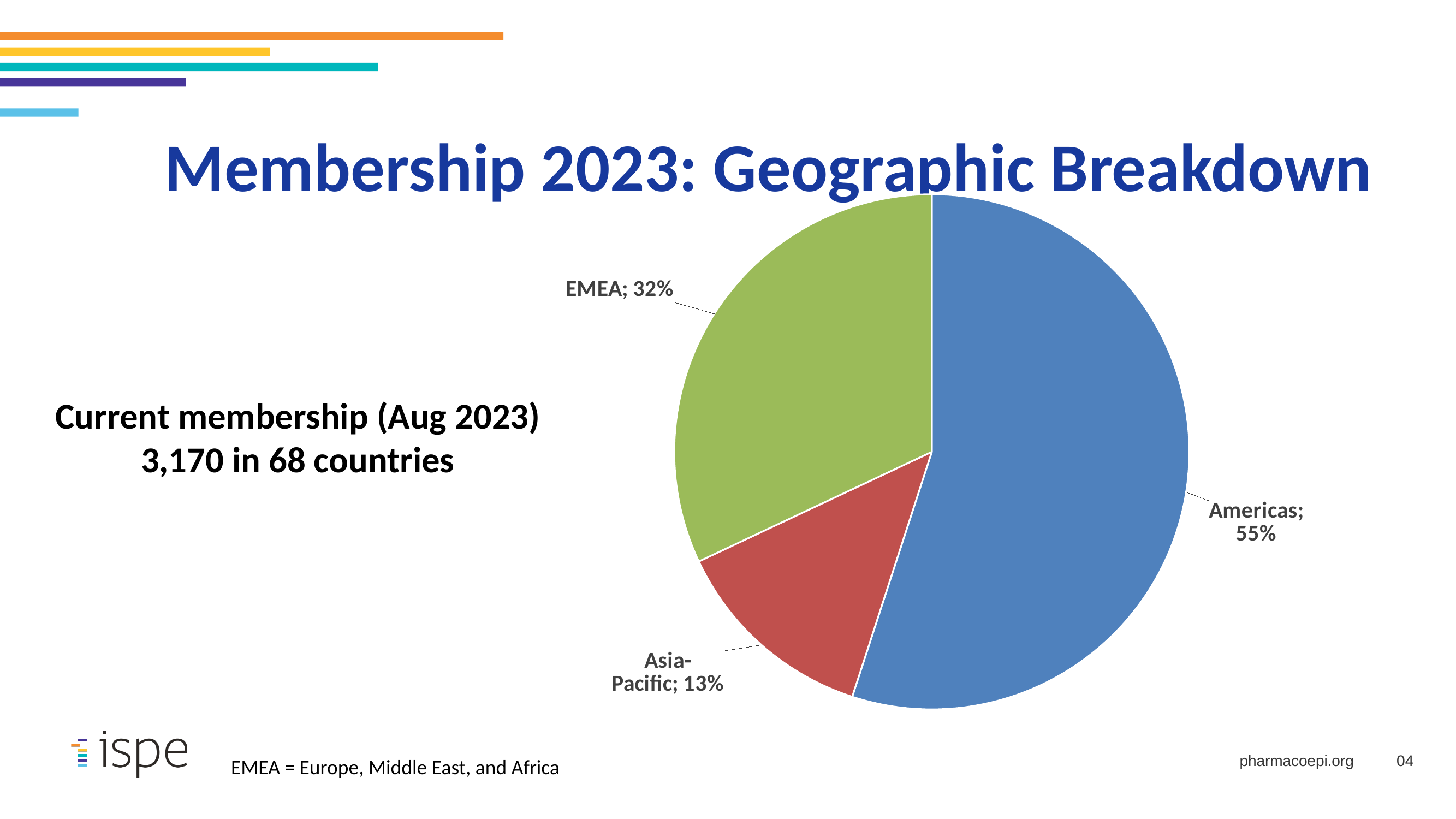
Which region has the largest share of membership? Americas What type of chart is shown on the slide? pie chart Which region has the smallest share of membership? Asia-Pacific What share of membership is from Asia-Pacific? 13% What share of membership is from EMEA? 32% How many regions are shown in the pie chart? 3 Which region has a larger share, EMEA or Asia-Pacific? EMEA What colour is the Americas slice of the pie chart? blue What is the title of the slide containing the pie chart? Membership 2023: Geographic Breakdown What is the difference in percentage points between the EMEA and Asia-Pacific shares? 19 What is the difference in percentage points between the Americas and EMEA shares? 23 What share of membership is from the Americas? 55%